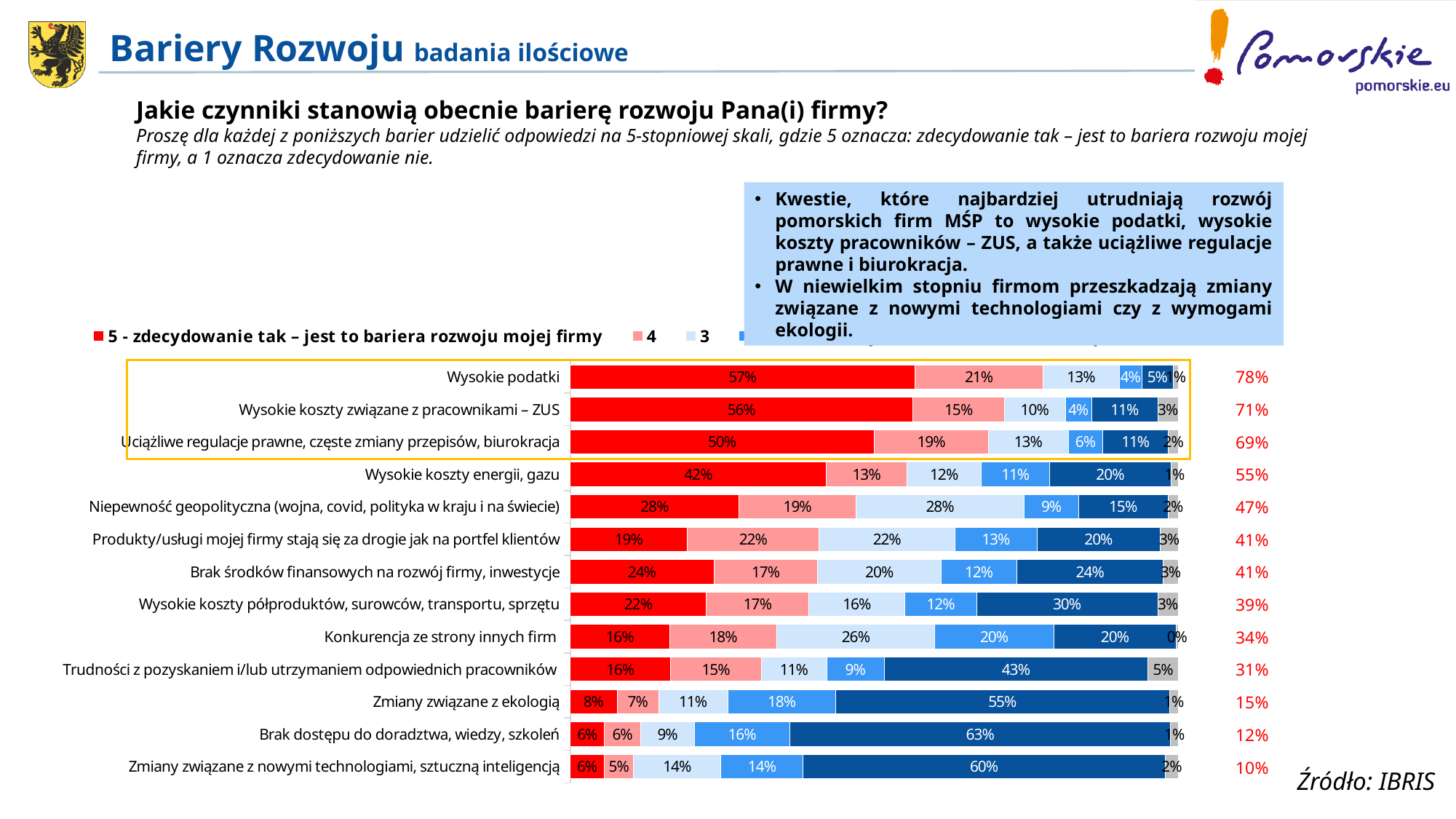
How many percentage points higher is the "3" segment for "Niepewność geopolityczna (wojna, covid, polityka w kraju i na świecie)" than for "Wysokie podatki"? 15 percentage points Which has a larger "4" segment: "Produkty/usługi mojej firmy stają się za drogie jak na portfel klientów" or "Brak środków finansowych na rozwój firmy, inwestycje"? Produkty/usługi mojej firmy stają się za drogie jak na portfel klientów Which barrier has the lowest red total shown at the right of the chart? Zmiany związane z nowymi technologiami, sztuczną inteligencją What kind of chart is shown on the slide? Stacked horizontal bar chart What is the combined share of the "5 - zdecydowanie tak" and "4" segments for "Konkurencja ze strony innych firm"? 34% Which barrier has the highest share of "5 - zdecydowanie tak" answers? Wysokie podatki How many barriers (categories) are listed in the chart? 13 What percentage of respondents answered "5 - zdecydowanie tak" for "Wysokie podatki"? 57% What is the red total shown at the right of the bar for "Trudności z pozyskaniem i/lub utrzymaniem odpowiednich pracowników"? 31% What is the full label of the first (red) legend entry? 5 - zdecydowanie tak – jest to bariera rozwoju mojej firmy What is the value of the "4" segment for "Wysokie koszty energii, gazu"? 13% What is the value of the "3" segment for "Zmiany związane z ekologią"? 11%